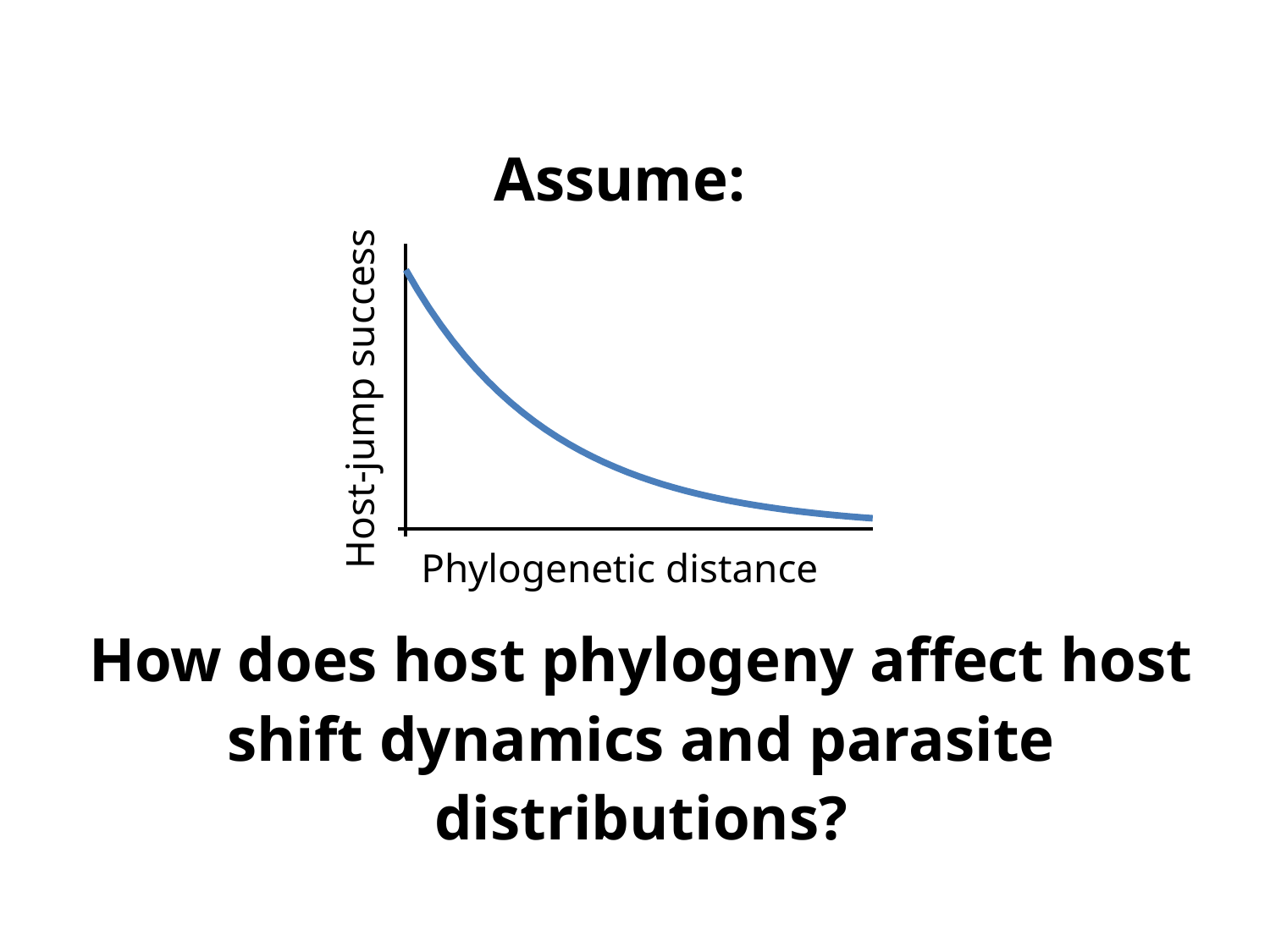
Is host-jump success highest at the smallest or the largest phylogenetic distance? smallest What is the label on the y axis of the chart? Host-jump success What kind of chart is shown on the slide? line chart Is host-jump success lowest at the smallest or the largest phylogenetic distance? largest Does host-jump success rise or fall as phylogenetic distance increases? fall What is the label on the x axis of the chart? Phylogenetic distance How many lines are plotted on the chart? 1